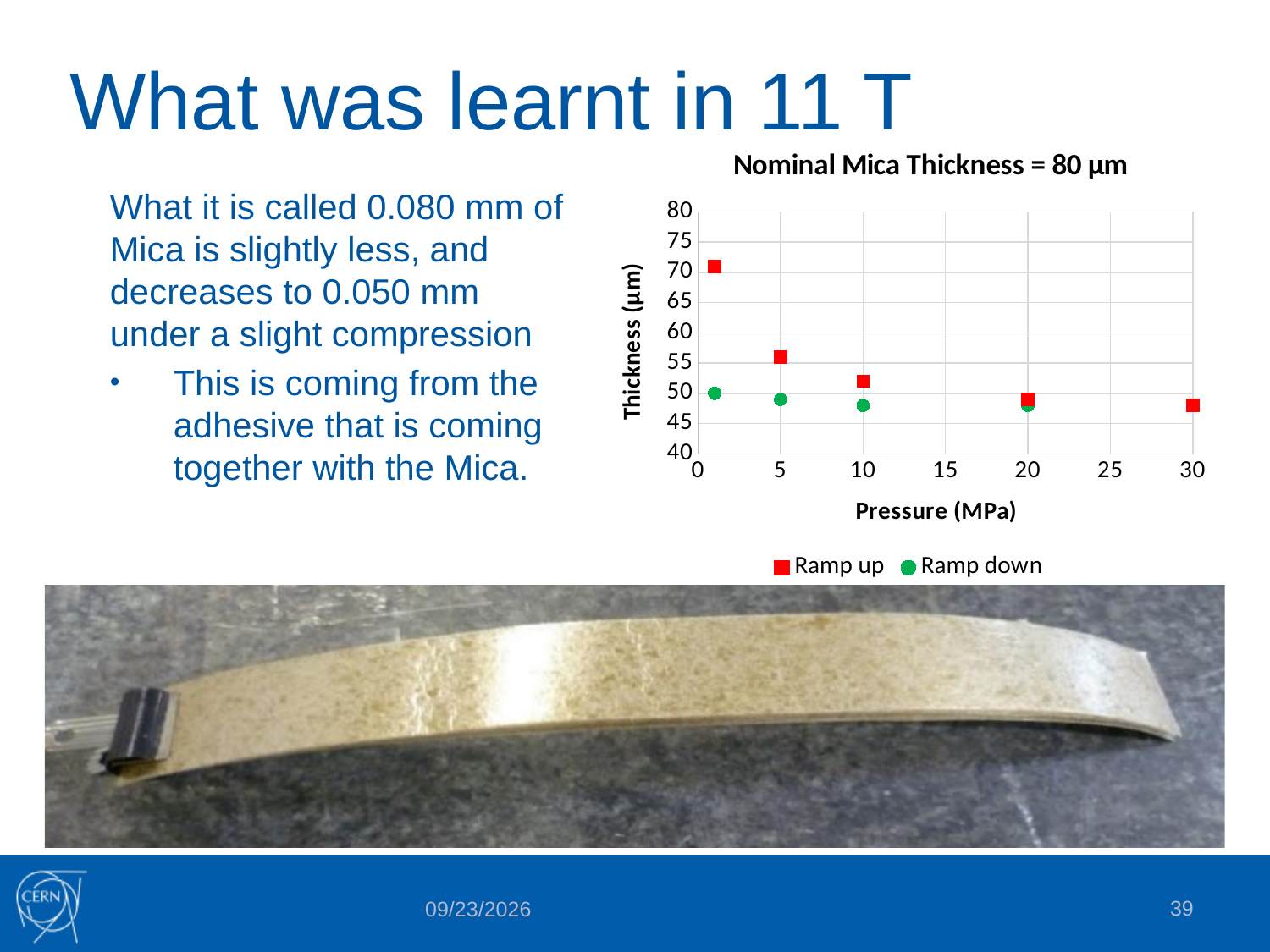
What is the title of the chart? Nominal Mica Thickness = 80 μm Is the Ramp up thickness at the lowest pressure (about 1 MPa) greater or less than 65 μm? greater Does the thickness for the Ramp up series rise or fall as pressure increases? fall What kind of chart is shown on the slide? scatter chart How many series does the chart legend list? 2 Is the Ramp down thickness at 10 MPa greater or less than 50 μm? less Which series contains the highest thickness value plotted on the chart? Ramp up How many data points are plotted for the Ramp up series? 5 At 5 MPa, which series shows the larger thickness, Ramp up or Ramp down? Ramp up Is the Ramp up thickness at 5 MPa greater or less than 50 μm? greater What are the names of the two series in the chart legend? Ramp up and Ramp down How many data points are plotted for the Ramp down series? 4